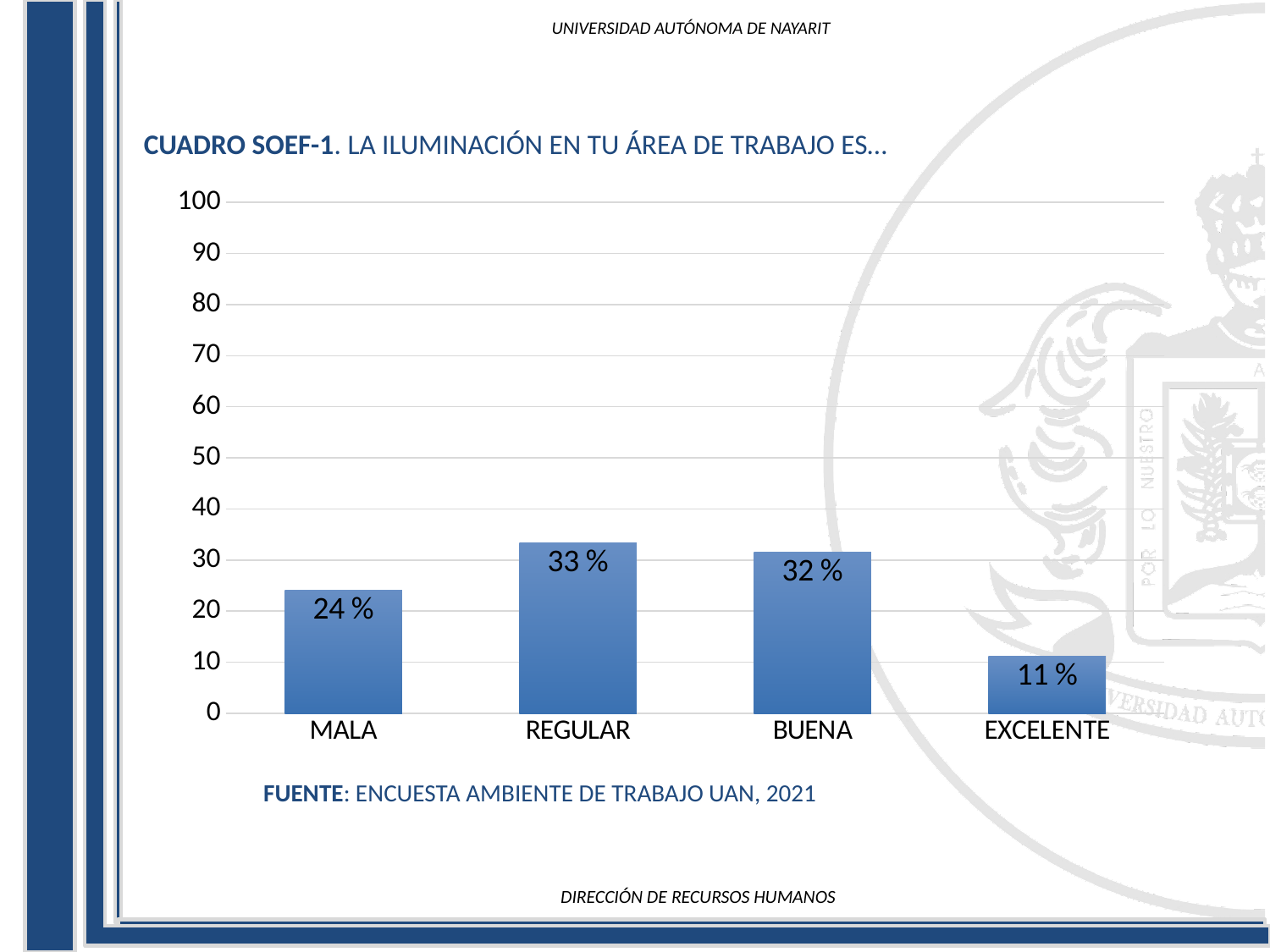
Which category has the highest value? REGULAR What is the source cited below the chart? ENCUESTA AMBIENTE DE TRABAJO UAN, 2021 What is the difference between the values for MALA and EXCELENTE? 13 % What is the difference between the values for REGULAR and EXCELENTE? 22 % How many categories are shown on the x axis? 4 What is the value for BUENA? 32 % What is the value for MALA? 24 % What kind of chart is shown on the slide? Bar chart What is the value for EXCELENTE? 11 % What is the value for REGULAR? 33 % Which is larger, the value for MALA or the value for BUENA? BUENA Which category has the lowest value? EXCELENTE